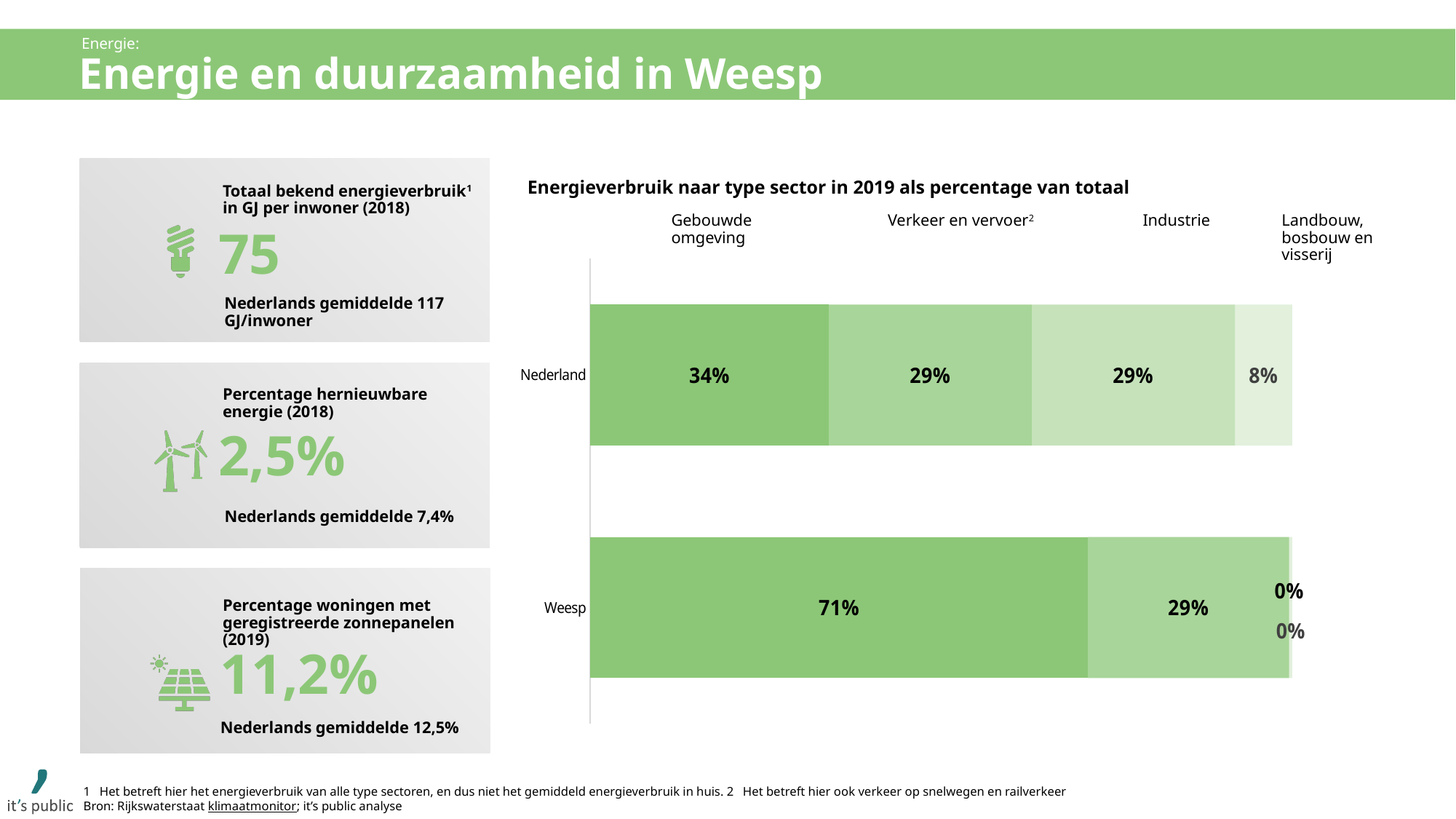
What is the value for Landbouw, bosbouw en visserij for Nederland? 8% What is the difference between the Gebouwde omgeving share for Weesp and for Nederland? 37 percentage points What is the value for Industrie for Weesp? 0% What type of chart is used to show energy consumption by sector type in 2019? stacked bar chart Which sector has the largest share of energy consumption for Weesp? Gebouwde omgeving How many sectors (series) are shown in the chart? 4 What is the value for Gebouwde omgeving for Nederland? 34% What is the value for Industrie for Nederland? 29% Which has a larger Gebouwde omgeving share, Nederland or Weesp? Weesp Which sector has the smallest share of energy consumption for Nederland? Landbouw, bosbouw en visserij What is the value for Gebouwde omgeving for Weesp? 71% How many bars (regions) are shown in the chart? 2